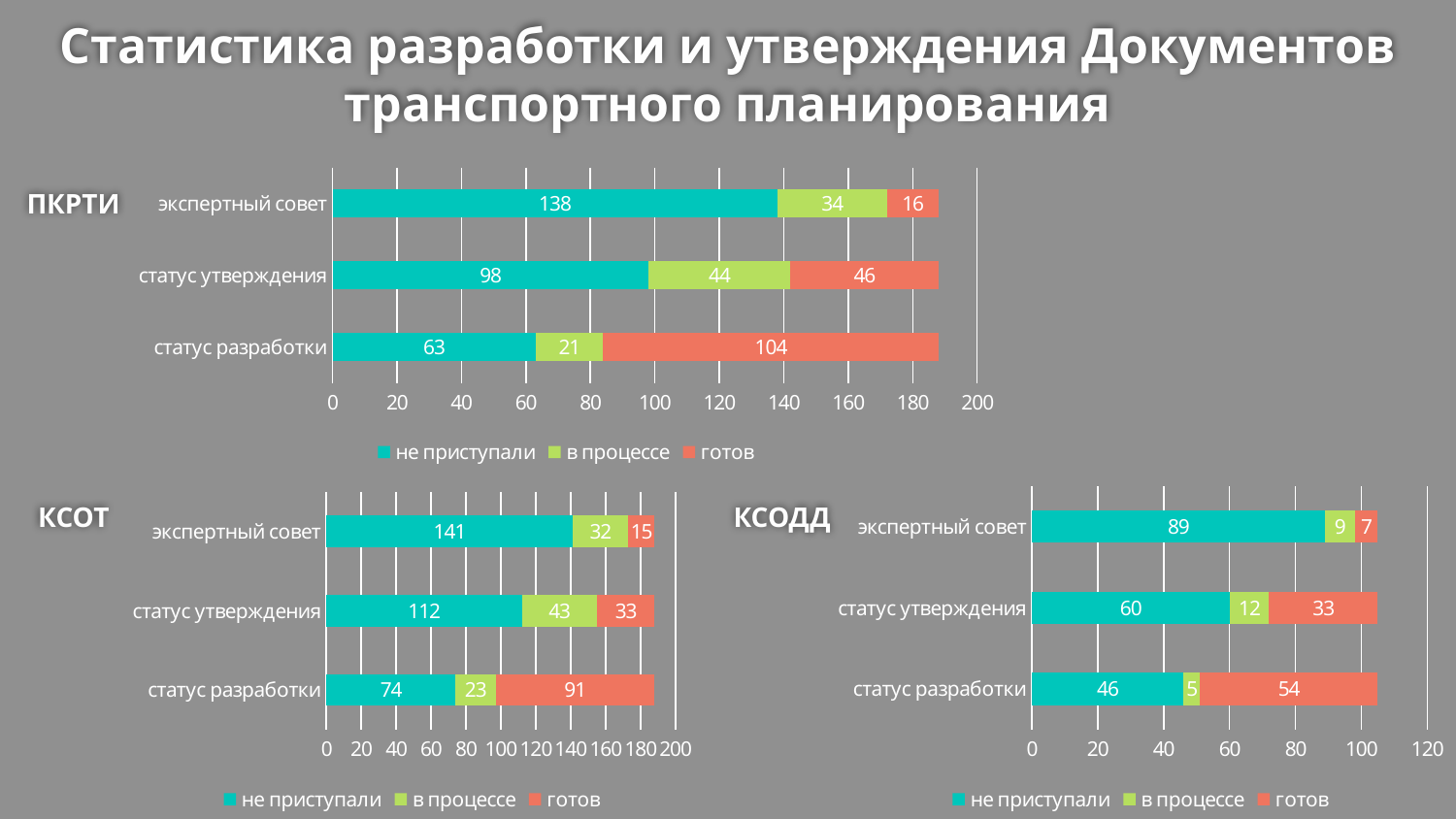
In the КСОДД chart, which category has the lowest 'в процессе' value? статус разработки In the ПКРТИ chart, what is the total of the stacked bar for 'статус утверждения'? 188 In the КСОДД chart, what is the total of the stacked bar for 'экспертный совет'? 105 What type of chart is the КСОТ chart? stacked bar chart In the КСОТ chart, which category has the highest 'готов' value? статус разработки How many series does the legend of the ПКРТИ chart list? 3 In the КСОТ chart, what is the value of 'в процессе' for 'статус утверждения'? 43 In the КСОДД chart, what is the value of 'готов' for 'статус утверждения'? 33 In the ПКРТИ chart, what is the value of 'готов' for 'статус разработки'? 104 In the ПКРТИ chart, what is the value of 'не приступали' for 'экспертный совет'? 138 In the КСОДД chart, is 'не приступали' larger for 'экспертный совет' or for 'статус разработки'? экспертный совет In the КСОТ chart, what is the difference between 'не приступали' for 'экспертный совет' and for 'статус разработки'? 67